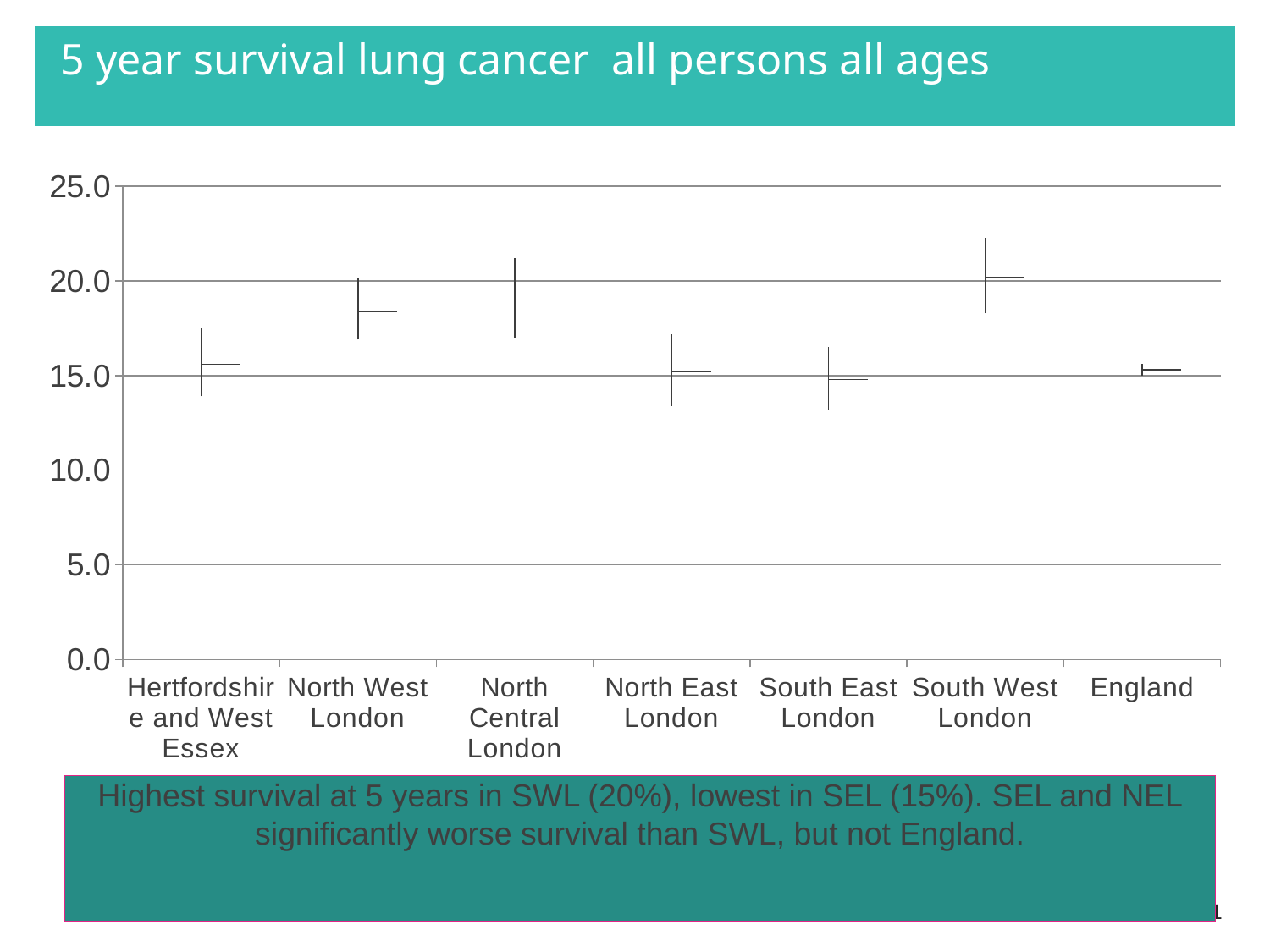
Is the value for South East London greater or less than 20.0? less Is the value for Hertfordshire and West Essex greater or less than 20.0? less What is the highest value shown on the y axis of the chart? 25.0 How many areas are shown along the x axis of the chart? 7 Which is larger, the value for North Central London or the value for Hertfordshire and West Essex? North Central London Is the value for North Central London greater or less than 15.0? greater What is the title of the chart? 5 year survival lung cancer all persons all ages Which is larger, the value for South West London or the value for England? South West London Which area has the highest 5 year survival value on the chart? South West London Which is larger, the value for North West London or the value for North East London? North West London